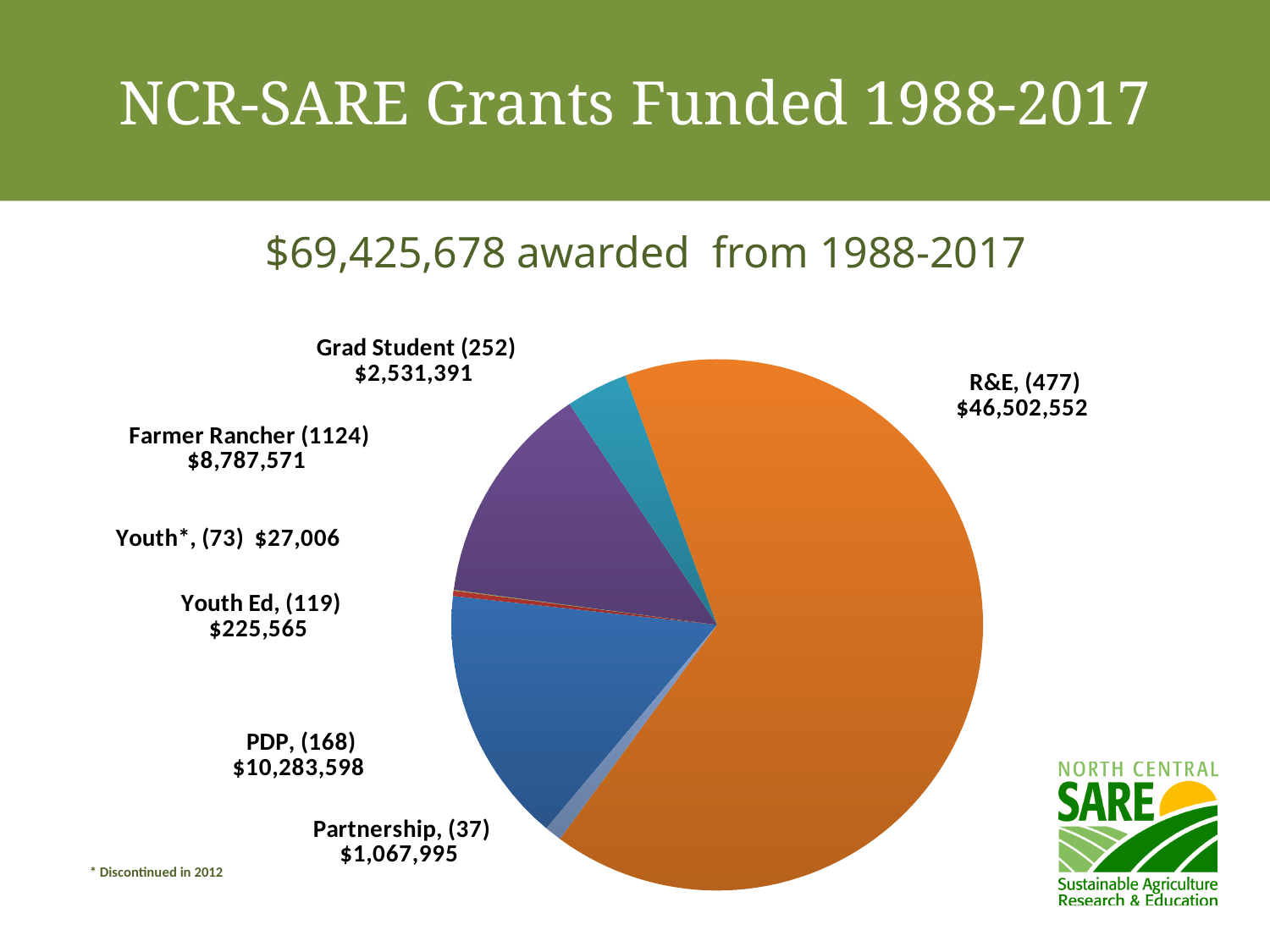
How many Farmer Rancher grants are shown in the pie chart label? 1124 Which category has the smallest dollar amount in the pie chart? Youth* What total amount awarded from 1988-2017 is stated on the slide? $69,425,678 What type of chart is shown on the slide? Pie chart How many Youth Ed grants are shown in the pie chart label? 119 Which received more funding, PDP or Farmer Rancher? PDP How much funding is shown for R&E in the pie chart? $46,502,552 How many categories are shown in the pie chart? 7 What is the difference in dollars between PDP and Farmer Rancher funding? $1,496,027 How much funding is shown for Partnership grants? $1,067,995 Which category is marked as discontinued in 2012? Youth Which category has the largest slice of the pie chart? R&E